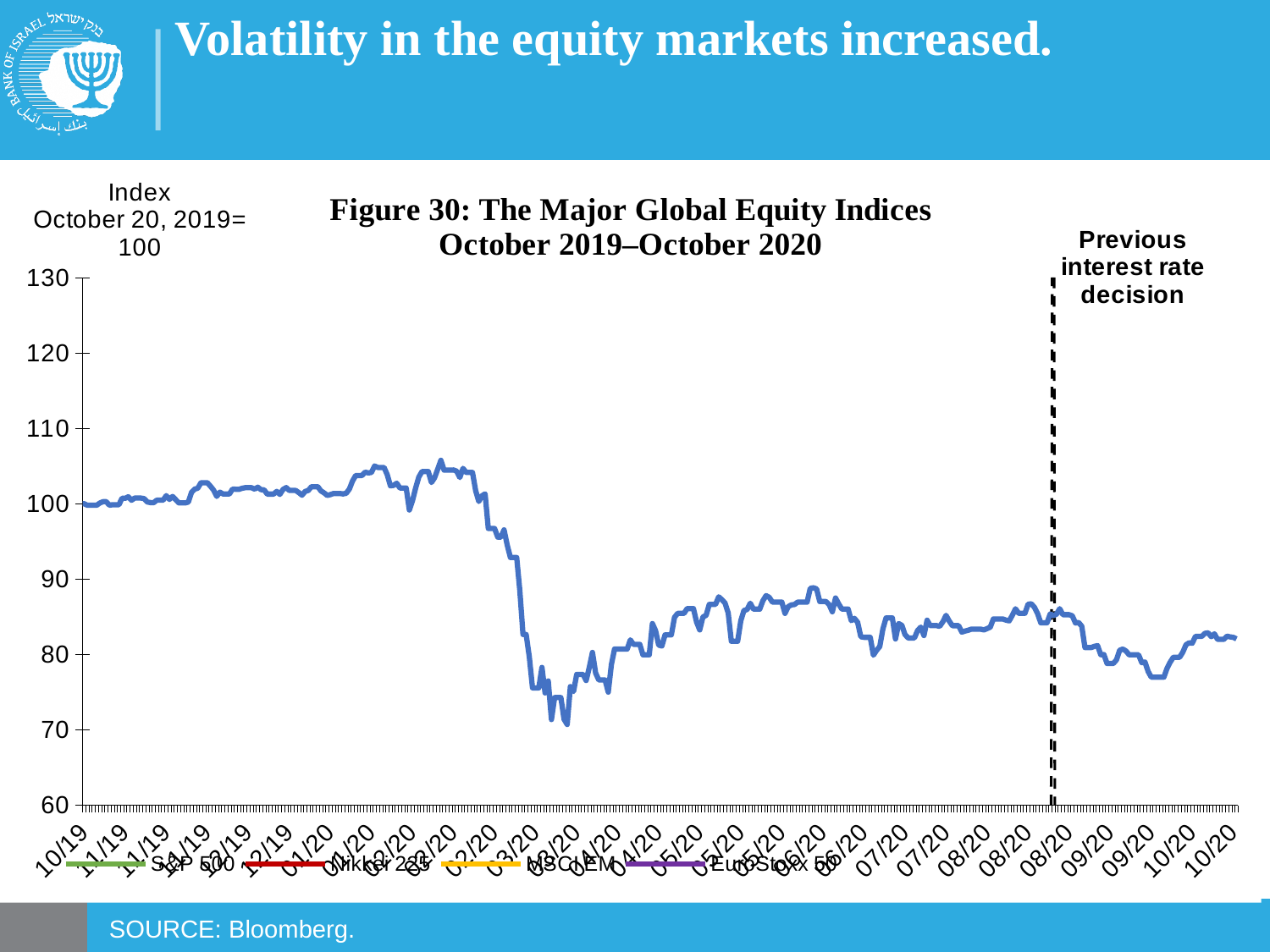
What kind of chart is shown on the slide? line chart Is the value of the line in January 2020 (1/20) greater or less than 100? greater Is the value of the line in August 2020 (8/20) greater or less than 90? less What does the dashed vertical line on the chart mark? Previous interest rate decision What is the title of the chart? Figure 30: The Major Global Equity Indices October 2019–October 2020 How many series does the chart's legend list? 4 In which month does the line reach its lowest point? 3/20 What is the index value on October 20, 2019, the base date of the index? 100 Is the lowest point of the line, in March 2020, greater or less than 80? less Is the value of the line in February 2020 (2/20) higher or lower than its value in April 2020 (4/20)? higher Does the line rise or fall between February 2020 and March 2020? fall